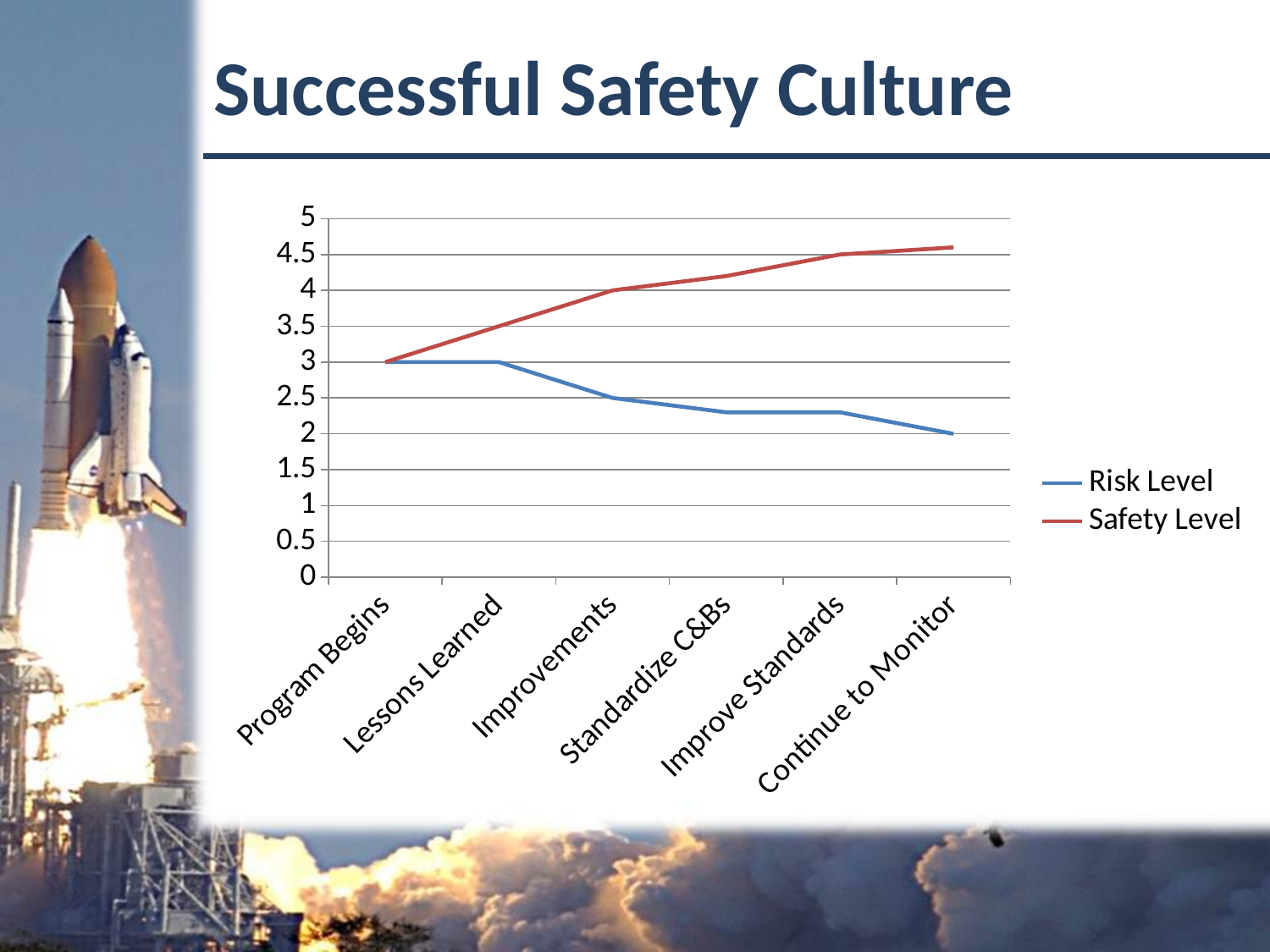
What kind of chart is shown on the slide? line chart Does the Safety Level series rise or fall from Program Begins to Continue to Monitor? rise What is the Safety Level value at Improvements? 4 What is the Risk Level value at Program Begins? 3 Does the Risk Level series rise or fall from Program Begins to Continue to Monitor? fall By how much does the Risk Level drop from Program Begins to Continue to Monitor? 1 At Continue to Monitor, which series has the higher value, Risk Level or Safety Level? Safety Level What is the Risk Level value at Continue to Monitor? 2 How many series does the legend list? 2 How many categories are shown along the x axis? 6 At which category is the Safety Level highest? Continue to Monitor Is the Safety Level value at Standardize C&Bs greater or less than 4? greater